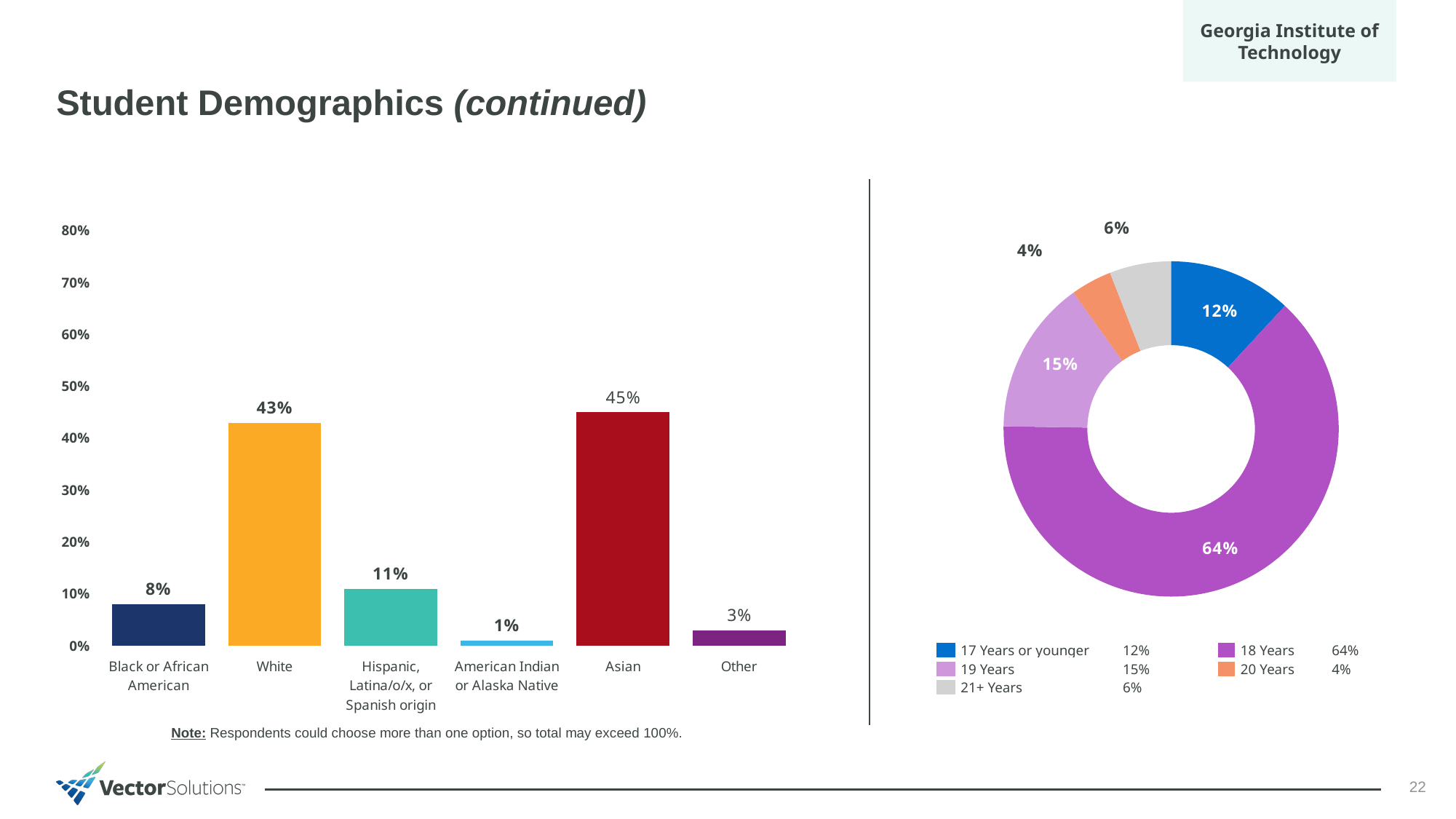
In the donut chart on the right, what is the value for 21+ Years? 6% In the bar chart on the left, which category has the highest value? Asian How many entries does the legend of the donut chart on the right list? 5 In the donut chart on the right, which age group has the smallest share? 20 Years In the bar chart on the left, which category has the lowest value? American Indian or Alaska Native In the bar chart on the left, what is the value for Hispanic, Latina/o/x, or Spanish origin? 11% In the bar chart on the left, which is larger, the value for Other or the value for Black or African American? Black or African American In the bar chart on the left, what is the value for Asian? 45% In the donut chart on the right, what share is 18 Years? 64% What kind of chart is on the left side of the slide? Bar chart How many categories are shown in the bar chart on the left? 6 In the bar chart on the left, what is the difference between the values for White and Black or African American? 35%